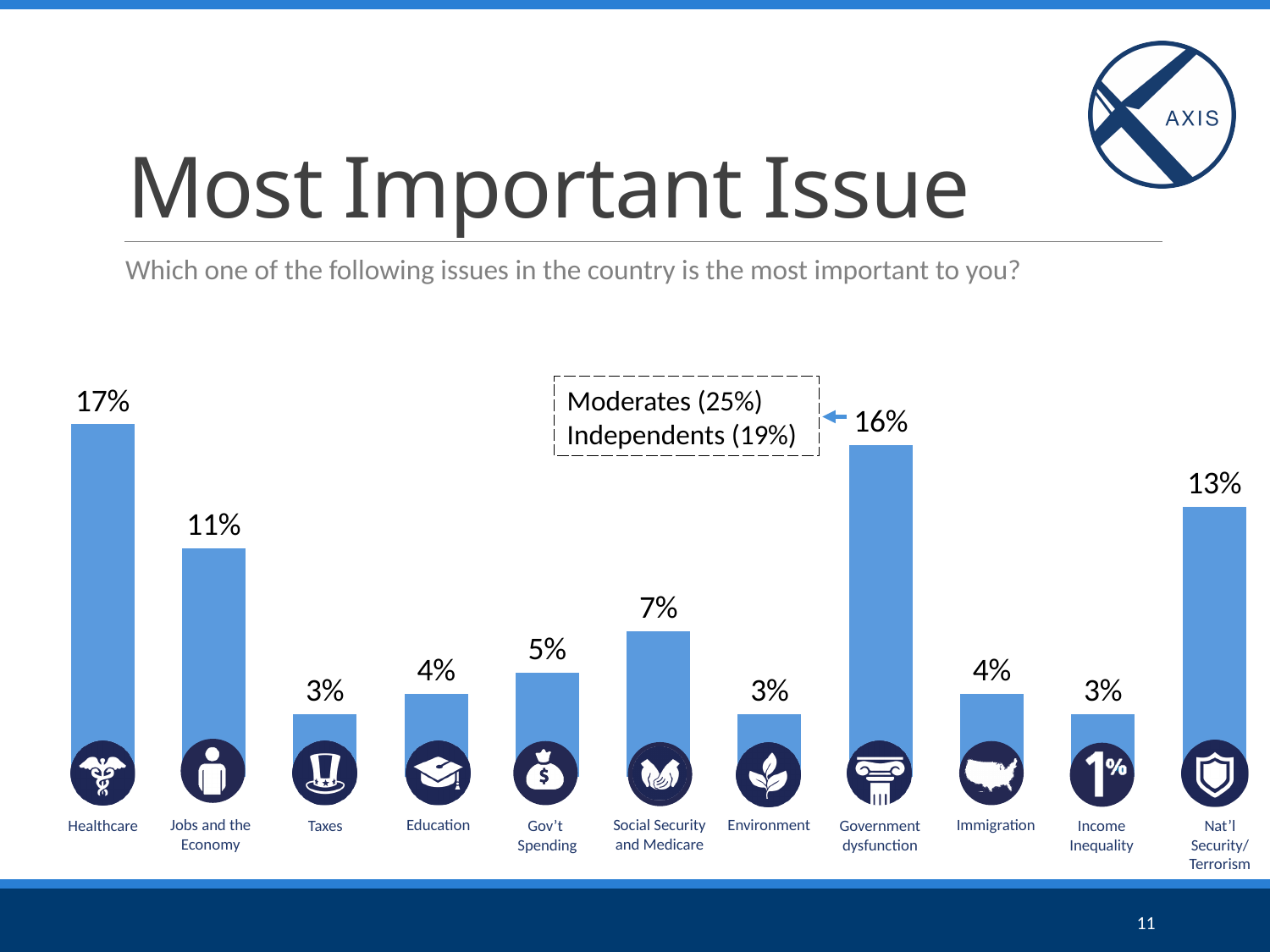
Which is larger, the value for Jobs and the Economy or the value for Nat'l Security/Terrorism? Nat'l Security/Terrorism Which issue has the highest percentage? Healthcare Which is larger, the value for Gov't Spending or the value for Education? Gov't Spending What is the value shown for Nat'l Security/Terrorism? 13% What percentage of respondents chose Healthcare as the most important issue? 17% What is the difference between the values for Healthcare and Jobs and the Economy? 6% What is the value shown for Government dysfunction? 16% What is the value shown for Social Security and Medicare? 7% According to the callout box, what percentage of Moderates chose Government dysfunction? 25% What is the difference between the values for Government dysfunction and Nat'l Security/Terrorism? 3% How many issue categories are shown in the chart? 11 What kind of chart is shown on the slide? Bar chart